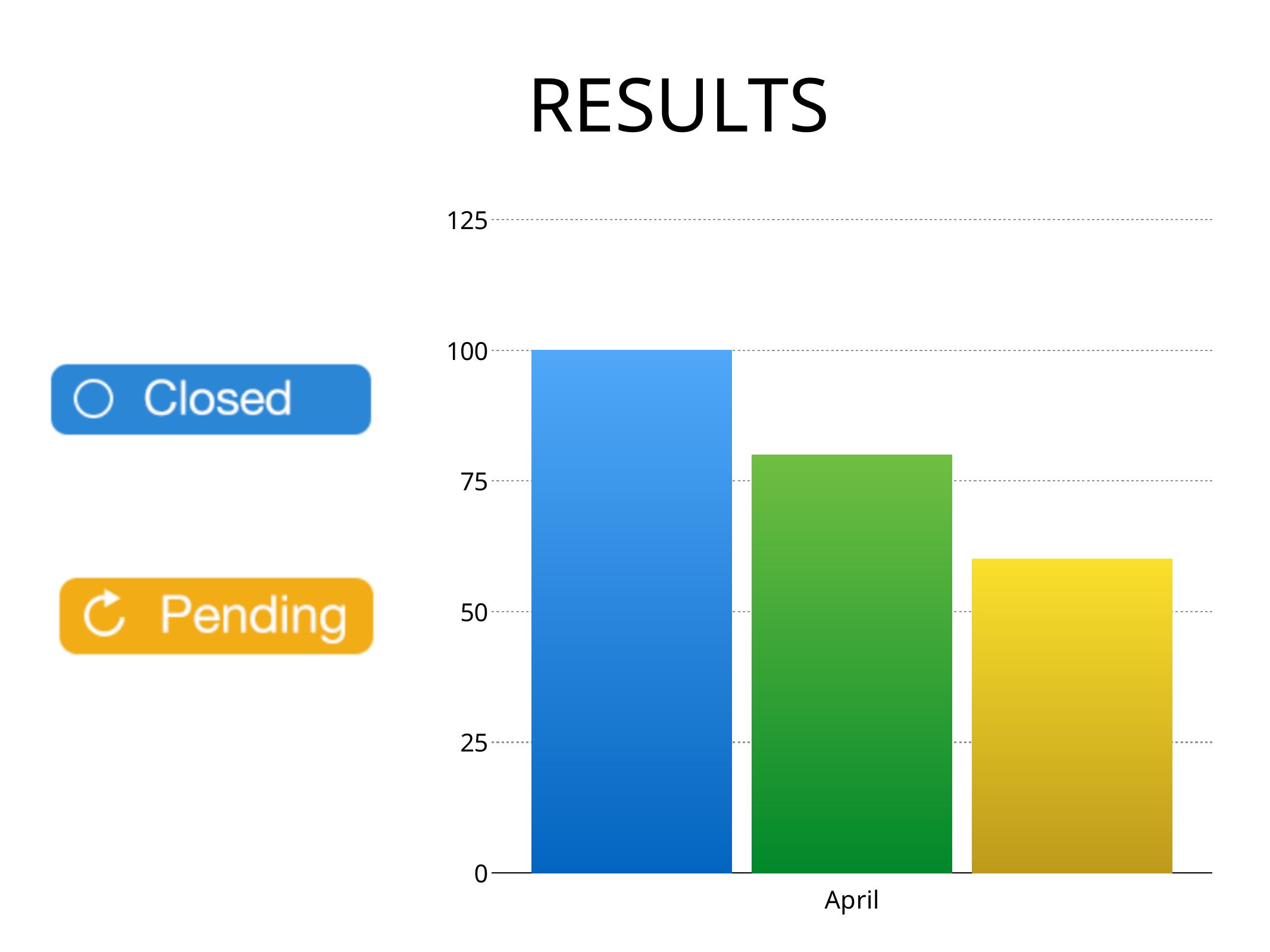
Is the value of the yellow bar for April greater or less than 75? less Which bar for April is the shortest? the yellow bar Is the value of the green bar for April greater or less than 100? less What kind of chart is shown on the slide? bar chart What is the value of the blue bar for April? 100 What is the title of the slide containing the chart? RESULTS Which is larger for April, the green bar or the yellow bar? the green bar Is the value of the yellow bar for April greater or less than 50? greater Which bar for April is the tallest? the blue bar How many categories are shown on the x axis of the chart? 1 What is the category label on the x axis of the chart? April